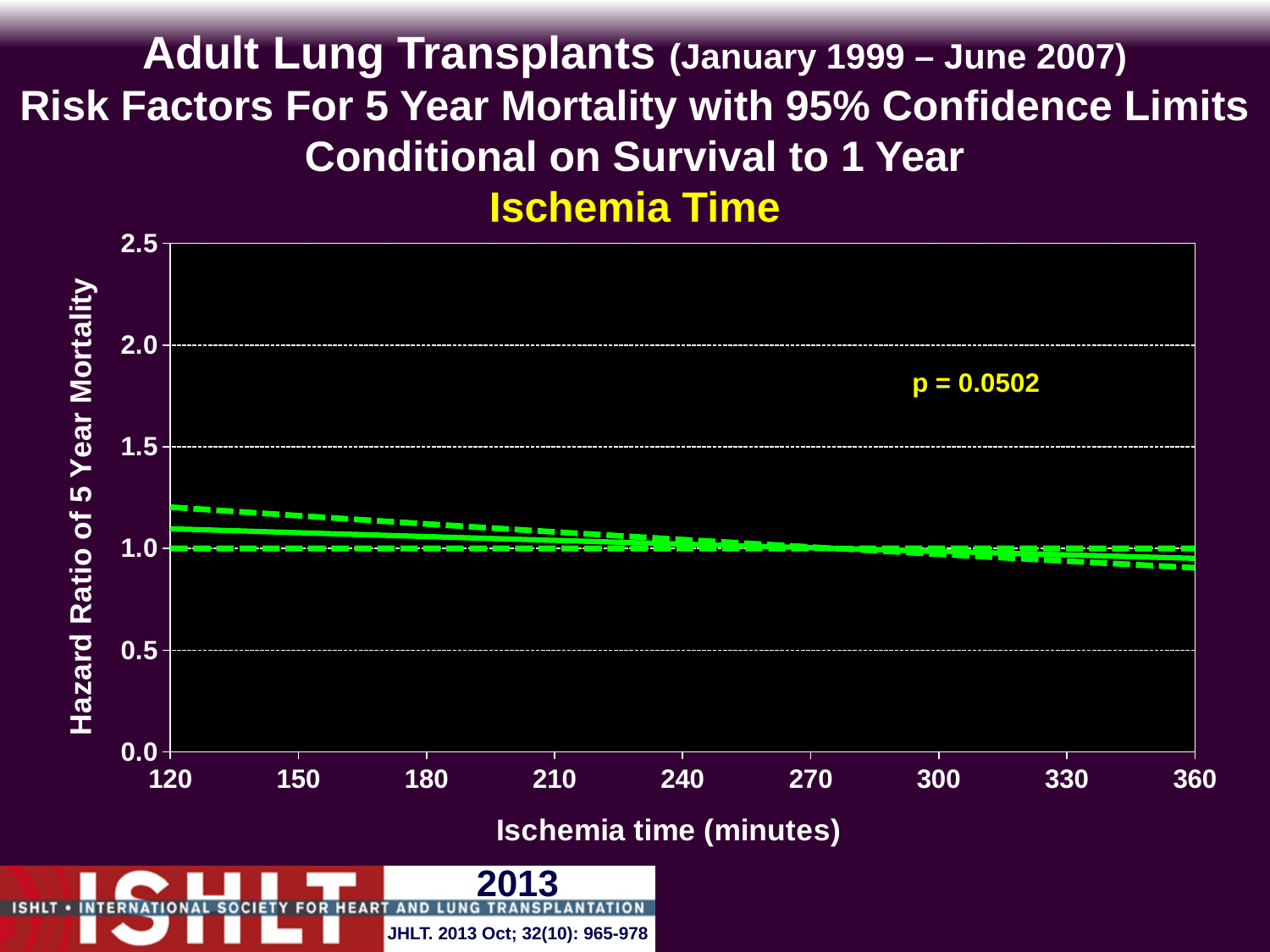
What p-value is printed on the chart? p = 0.0502 What is the label of the y axis? Hazard Ratio of 5 Year Mortality What is the lowest ischemia time labelled on the x axis? 120 How many tick labels are shown on the x axis (ischemia time)? 9 Is the hazard ratio at an ischemia time of 360 minutes greater or less than 1.5? less Is the hazard ratio at an ischemia time of 120 minutes greater or less than 1.5? less Does the hazard ratio of 5 year mortality rise or fall as ischemia time increases from 120 to 360 minutes? fall Which has the larger hazard ratio: an ischemia time of 120 minutes or 360 minutes? 120 minutes What kind of chart is shown on the slide? line chart What is the highest value labelled on the y axis? 2.5 Is the upper 95% confidence limit at an ischemia time of 120 minutes greater or less than 1.0? greater